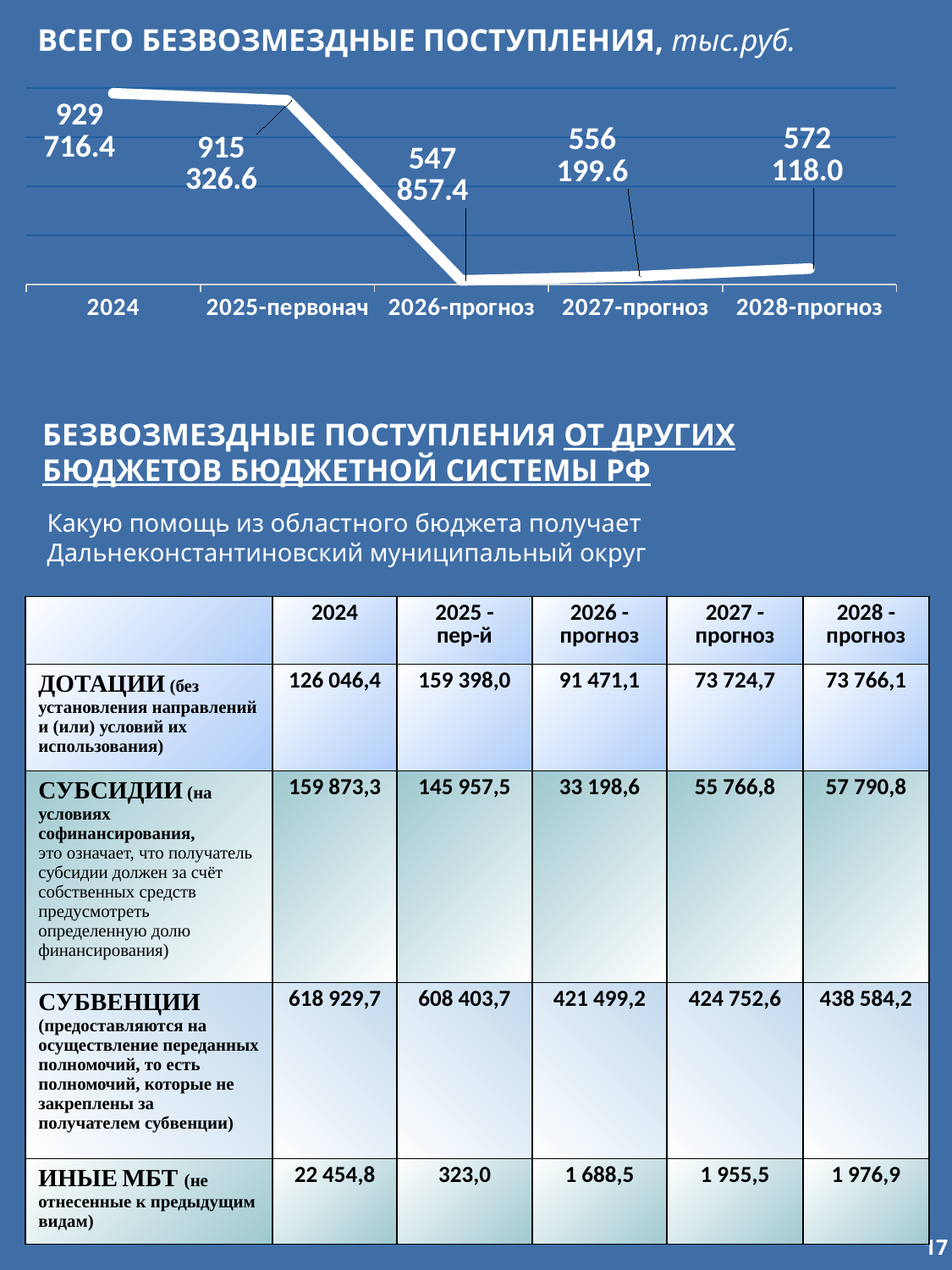
Which category has the highest value in the chart 'ВСЕГО БЕЗВОЗМЕЗДНЫЕ ПОСТУПЛЕНИЯ, тыс.руб.'? 2024 What is the value for 2024 in the chart 'ВСЕГО БЕЗВОЗМЕЗДНЫЕ ПОСТУПЛЕНИЯ, тыс.руб.'? 929 716.4 What is the value for 2028-прогноз in the chart 'ВСЕГО БЕЗВОЗМЕЗДНЫЕ ПОСТУПЛЕНИЯ, тыс.руб.'? 572 118.0 In the chart 'ВСЕГО БЕЗВОЗМЕЗДНЫЕ ПОСТУПЛЕНИЯ, тыс.руб.', what is the difference between the values for 2024 and 2025-первонач? 14 389.8 Which category has the lowest value in the chart 'ВСЕГО БЕЗВОЗМЕЗДНЫЕ ПОСТУПЛЕНИЯ, тыс.руб.'? 2026-прогноз In the chart 'ВСЕГО БЕЗВОЗМЕЗДНЫЕ ПОСТУПЛЕНИЯ, тыс.руб.', what is the difference between the values for 2028-прогноз and 2026-прогноз? 24 260.6 What is the value for 2025-первонач in the chart 'ВСЕГО БЕЗВОЗМЕЗДНЫЕ ПОСТУПЛЕНИЯ, тыс.руб.'? 915 326.6 How many data points are plotted in the chart 'ВСЕГО БЕЗВОЗМЕЗДНЫЕ ПОСТУПЛЕНИЯ, тыс.руб.'? 5 In the chart 'ВСЕГО БЕЗВОЗМЕЗДНЫЕ ПОСТУПЛЕНИЯ, тыс.руб.', do the values rise or fall from 2025-первонач to 2026-прогноз? Fall What is the value for 2026-прогноз in the chart 'ВСЕГО БЕЗВОЗМЕЗДНЫЕ ПОСТУПЛЕНИЯ, тыс.руб.'? 547 857.4 In the chart 'ВСЕГО БЕЗВОЗМЕЗДНЫЕ ПОСТУПЛЕНИЯ, тыс.руб.', which is larger: the value for 2027-прогноз or the value for 2028-прогноз? 2028-прогноз What type of chart is 'ВСЕГО БЕЗВОЗМЕЗДНЫЕ ПОСТУПЛЕНИЯ, тыс.руб.'? Line chart